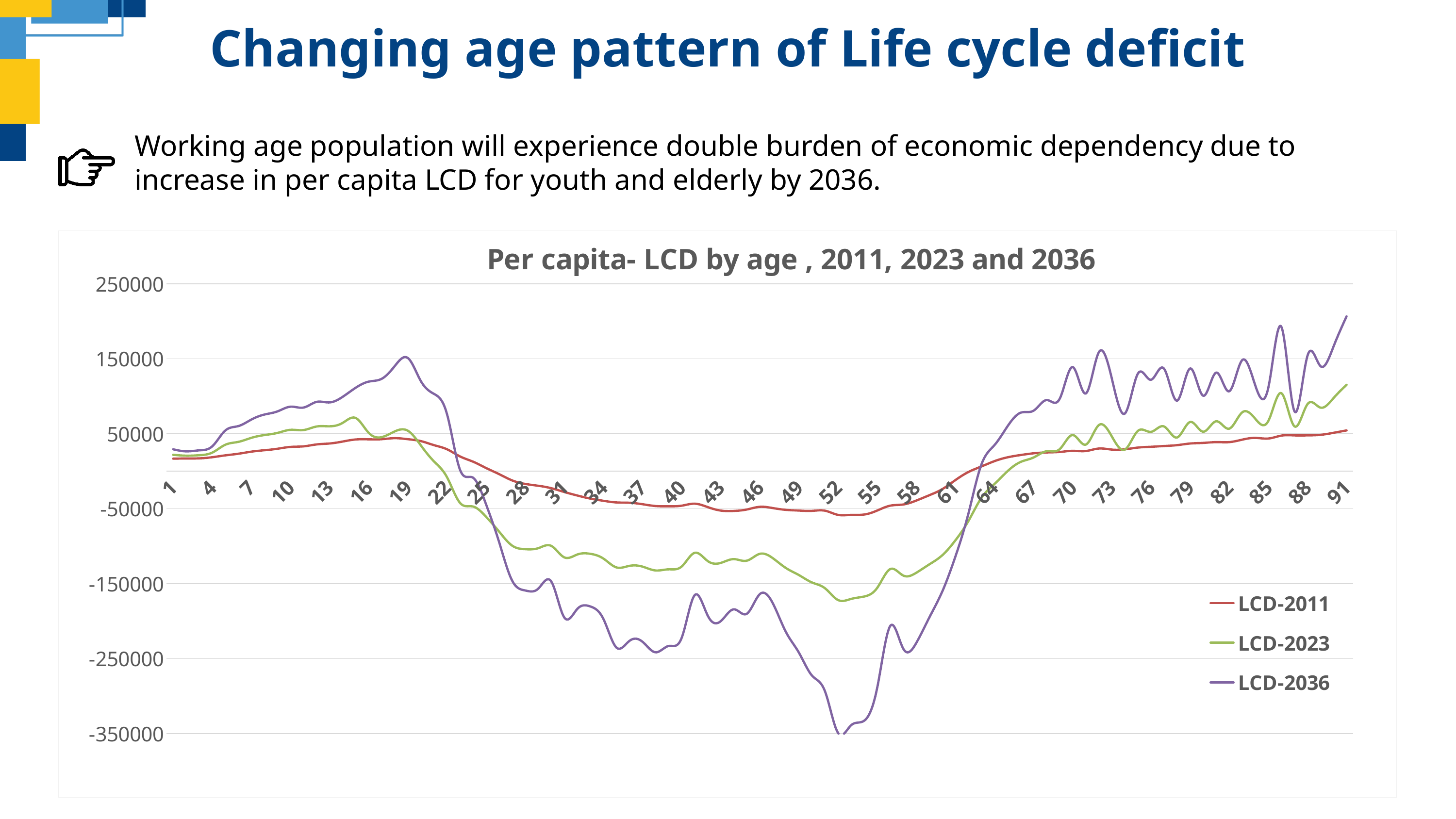
How many series does the legend list? 3 Is the value for LCD-2023 at age 91 greater or less than 50000? greater Is the value for LCD-2036 at age 91 greater or less than 150000? greater Which series reaches the lowest value anywhere on the chart? LCD-2036 Does the LCD-2011 line rise or fall between age 19 and age 52? Fall What is the title of the chart? Per capita- LCD by age , 2011, 2023 and 2036 At age 52, which series has the lower value, LCD-2011 or LCD-2036? LCD-2036 Which series is drawn in purple? LCD-2036 Is the value for LCD-2036 at age 52 greater or less than -250000? less What kind of chart is shown on the slide? Line chart Which series reaches the highest value anywhere on the chart? LCD-2036